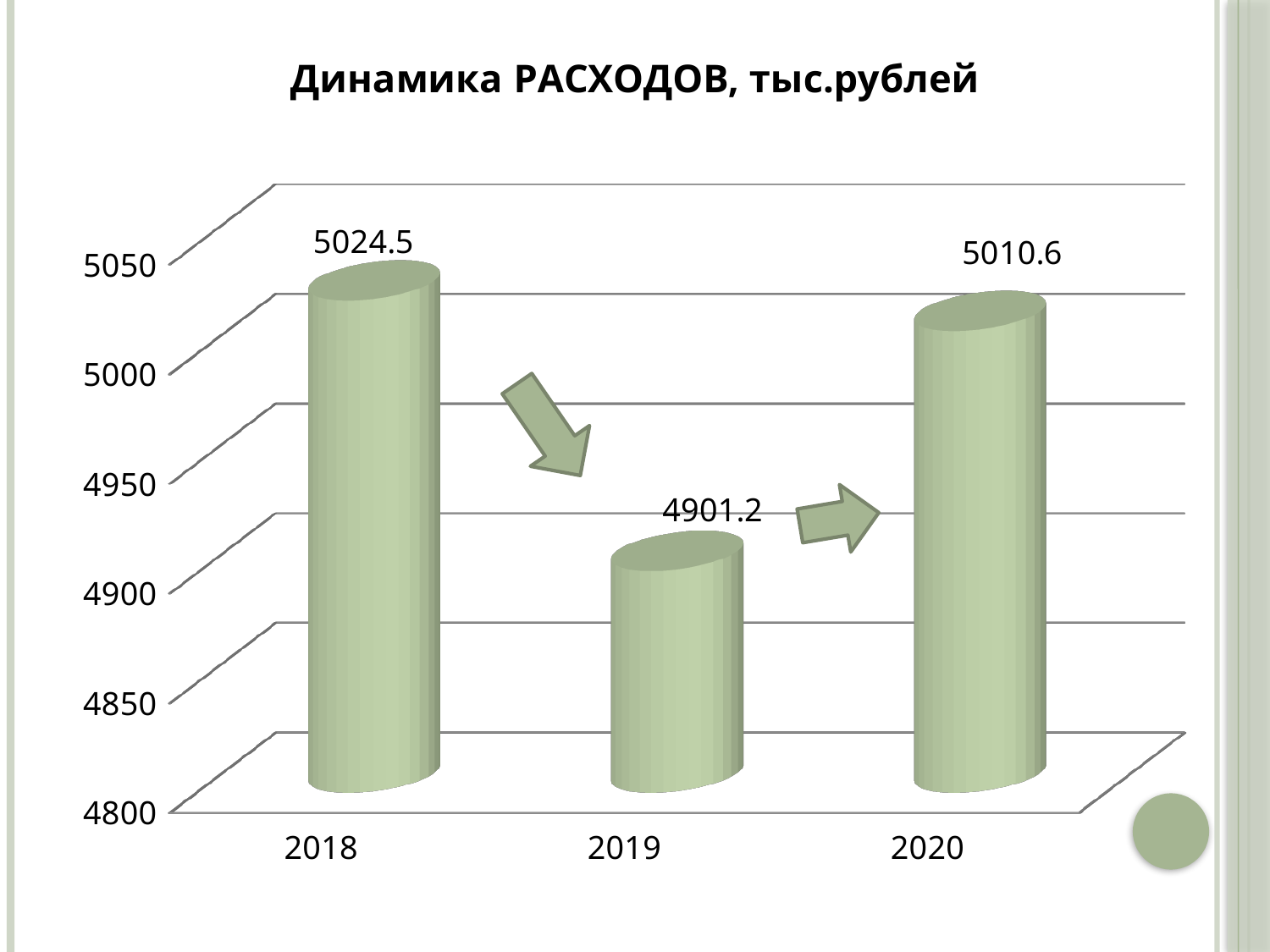
What is the value for 2020? 5010.6 Which is larger, the value for 2018 or the value for 2020? 2018 What is the title of the chart? Динамика РАСХОДОВ, тыс.рублей What is the difference between the values for 2020 and 2019? 109.4 What kind of chart is this? bar chart How many years are shown on the chart? 3 Is the value for 2019 greater or less than 4950? less Which year has the lowest value? 2019 What is the value for 2018? 5024.5 What is the value for 2019? 4901.2 Which year has the highest value? 2018 What is the difference between the values for 2018 and 2019? 123.3